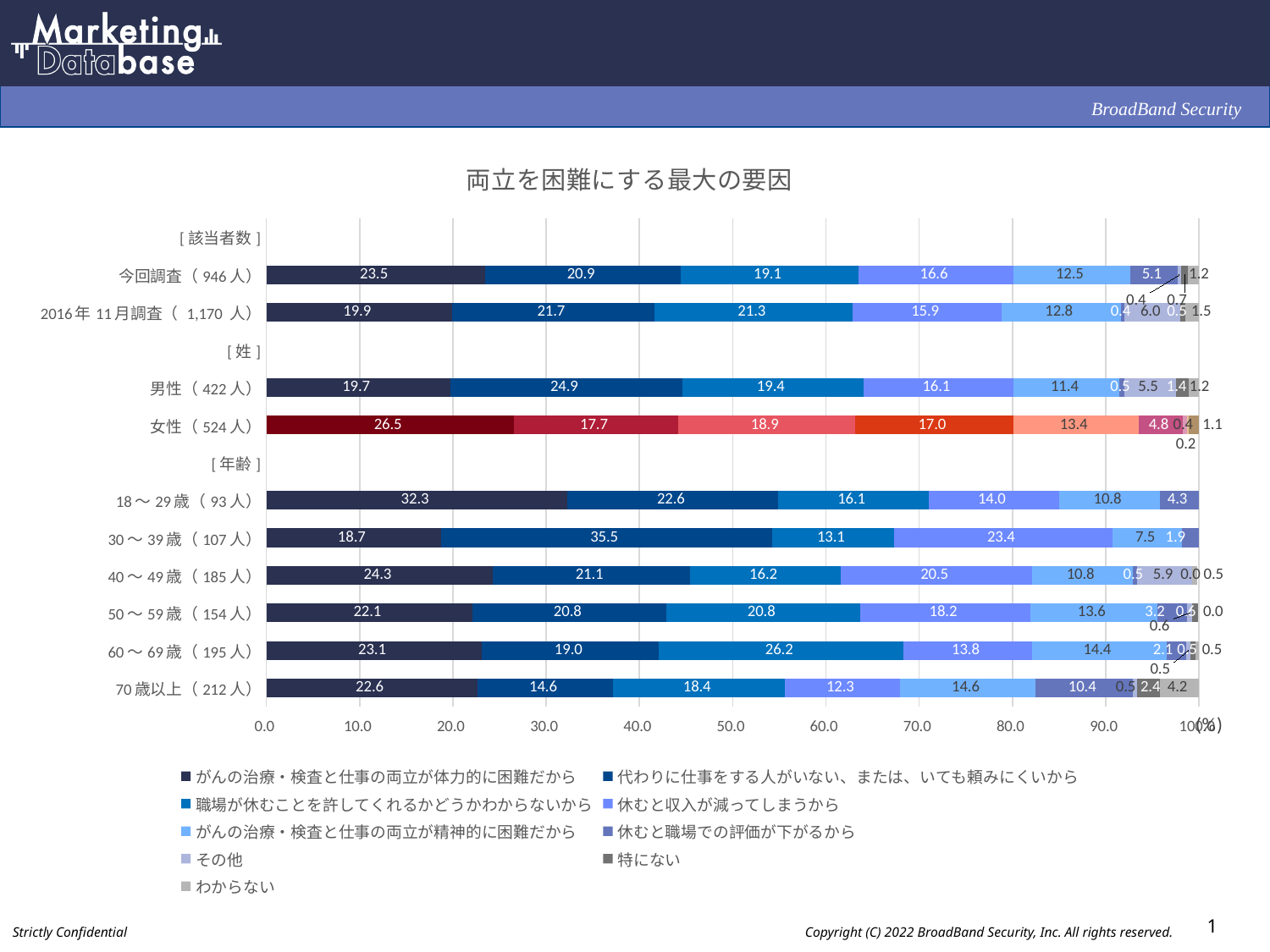
How many categories have bars plotted in the chart? 10 How many series does the legend list? 9 What is the value of the 「がんの治療・検査と仕事の両立が体力的に困難だから」 segment for 女性 (524人)? 26.5 What kind of chart is shown on the slide? Stacked bar chart What is the title of the chart? 両立を困難にする最大の要因 Which has the larger value for 「がんの治療・検査と仕事の両立が体力的に困難だから」: 今回調査 (946人) or 2016年11月調査 (1,170人)? 今回調査 (946人) What is the value of the 「代わりに仕事をする人がいない、または、いても頼みにくいから」 segment for 30～39歳 (107人)? 35.5 What is the difference between 女性 (524人) and 男性 (422人) for 「がんの治療・検査と仕事の両立が体力的に困難だから」? 6.8 What is the value of the 「職場が休むことを許してくれるかどうかわからないから」 segment for 60～69歳 (195人)? 26.2 What is the value of the 「がんの治療・検査と仕事の両立が体力的に困難だから」 segment for 今回調査 (946人)? 23.5 Which category has the highest value for 「がんの治療・検査と仕事の両立が体力的に困難だから」? 18～29歳 (93人) What is the value of the 「休むと収入が減ってしまうから」 segment for 70歳以上 (212人)? 12.3